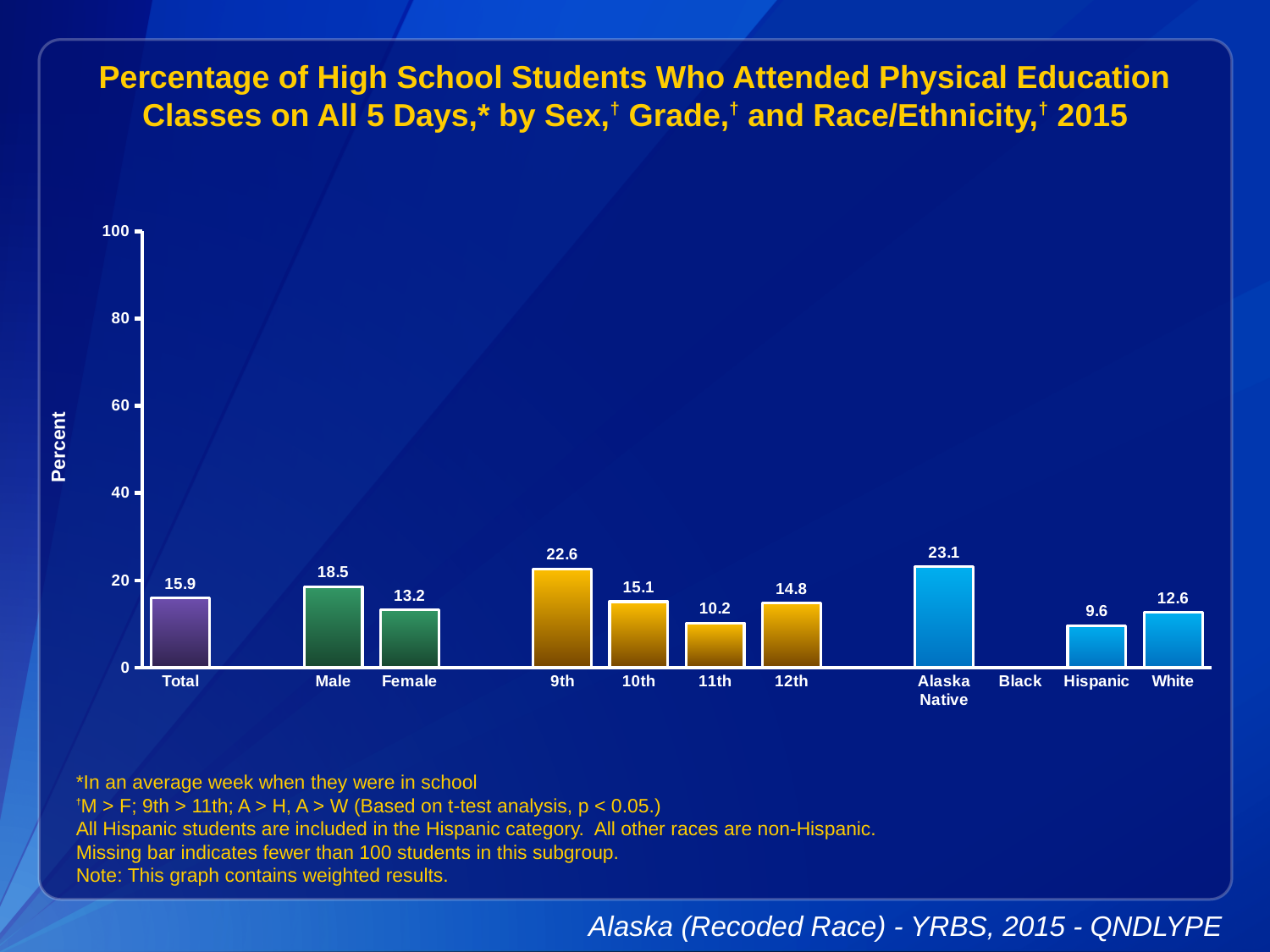
Which category on the x axis has no bar shown? Black What kind of chart is shown on the slide? bar chart Which category has the lowest value among those with a bar shown? Hispanic Which category has the highest value? Alaska Native Is the value for White greater or less than 20? less What is the value for Alaska Native? 23.1 What is the value for Total? 15.9 What is the label of the y axis? Percent Which is larger, the value for 9th grade or 12th grade? 9th What is the value for Female? 13.2 What is the difference between the values for Male and Female? 5.3 What is the value for 11th grade? 10.2